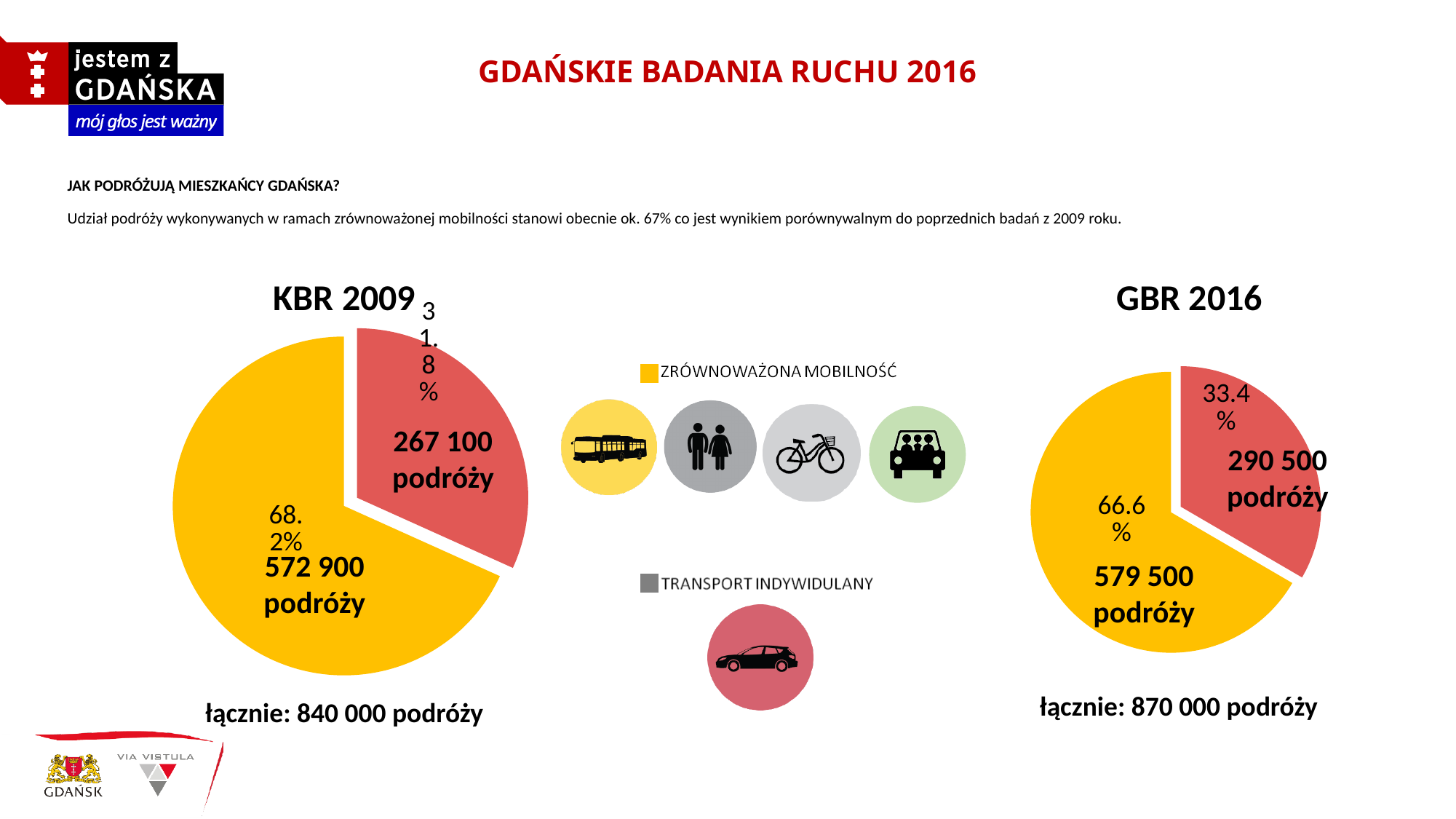
What is the total number of trips shown for the GBR 2016 chart? 870 000 podróży What kind of chart is the KBR 2009 chart? pie chart In the KBR 2009 chart, what percentage share does the ZRÓWNOWAŻONA MOBILNOŚĆ slice have? 68.2% In the GBR 2016 chart, which slice is the smallest? TRANSPORT INDYWIDULANY In the KBR 2009 chart, what percentage share does the TRANSPORT INDYWIDULANY slice have? 31.8% In the GBR 2016 chart, what percentage share does the TRANSPORT INDYWIDULANY slice have? 33.4% How many slices does the GBR 2016 pie chart have? 2 In the KBR 2009 chart, how many trips (podróży) are shown for the ZRÓWNOWAŻONA MOBILNOŚĆ slice? 572 900 podróży What is the difference in trips between the ZRÓWNOWAŻONA MOBILNOŚĆ slice and the TRANSPORT INDYWIDULANY slice in the KBR 2009 chart? 305 800 podróży In the KBR 2009 chart, which slice is the largest? ZRÓWNOWAŻONA MOBILNOŚĆ In the GBR 2016 chart, how many trips (podróży) are shown for the TRANSPORT INDYWIDULANY slice? 290 500 podróży